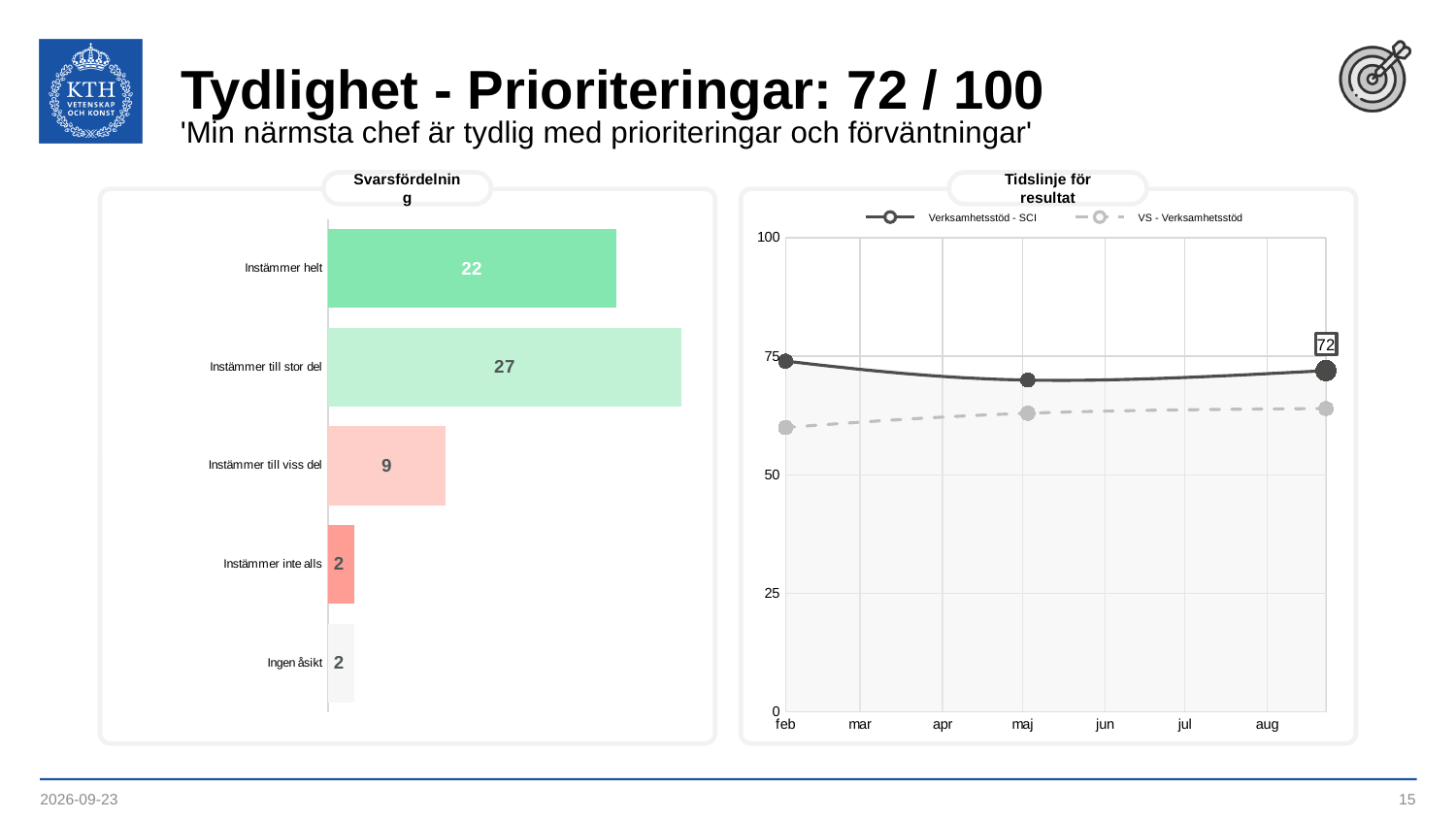
How many categories are shown in the Svarsfördelning chart? 5 What kind of chart is the Svarsfördelning chart? bar chart In the Svarsfördelning chart, which is larger: 'Instämmer till viss del' or 'Instämmer inte alls'? Instämmer till viss del In the Svarsfördelning chart, what is the value for 'Instämmer till viss del'? 9 In the Tidslinje för resultat chart, what is the labelled value of the last point of the 'Verksamhetsstöd - SCI' series? 72 In the Svarsfördelning chart, what is the value for 'Instämmer helt'? 22 In the Tidslinje för resultat chart, how many series does the legend list? 2 In the Svarsfördelning chart, which category has the highest value? Instämmer till stor del In the Svarsfördelning chart, what is the difference between 'Instämmer till stor del' and 'Instämmer helt'? 5 In the Tidslinje för resultat chart, is the value for 'VS - Verksamhetsstöd' in feb greater or less than 75? less What kind of chart is the Tidslinje för resultat chart? line chart In the Svarsfördelning chart, what is the value for 'Instämmer till stor del'? 27